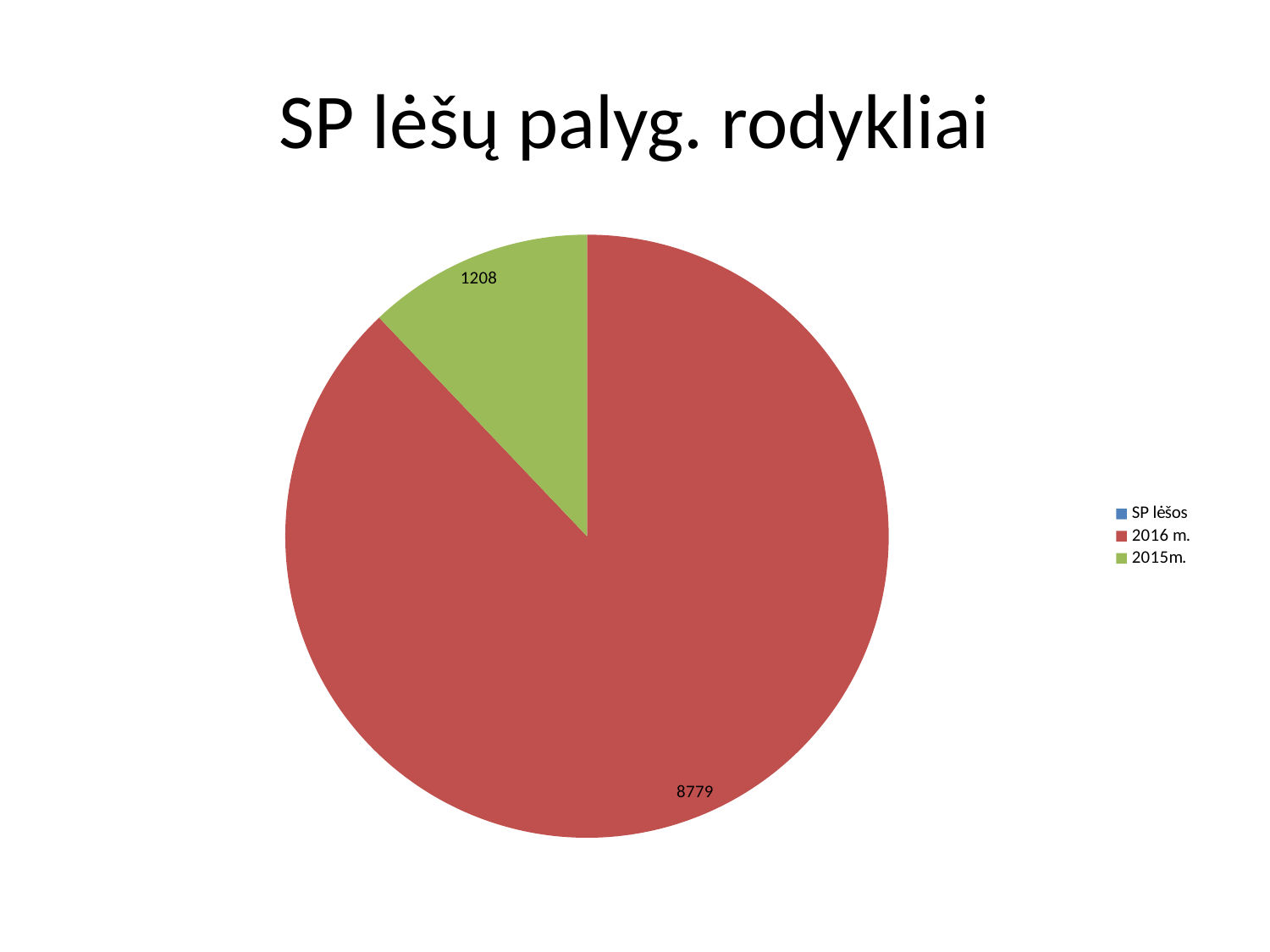
What is the title of the chart? SP lėšų palyg. rodykliai What colour is the 2015m. slice? green Which of the visible slices is the smallest? 2015m. What type of chart is shown on the slide? pie chart How many slices are visible in the pie chart? 2 Which slice is the largest in the pie chart? 2016 m. What is the difference between the 2016 m. value and the 2015m. value? 7571 How many entries does the legend list? 3 What is the value of the 2016 m. slice? 8779 What is the value of the 2015m. slice? 1208 Which is larger, the 2016 m. slice or the 2015m. slice? 2016 m.